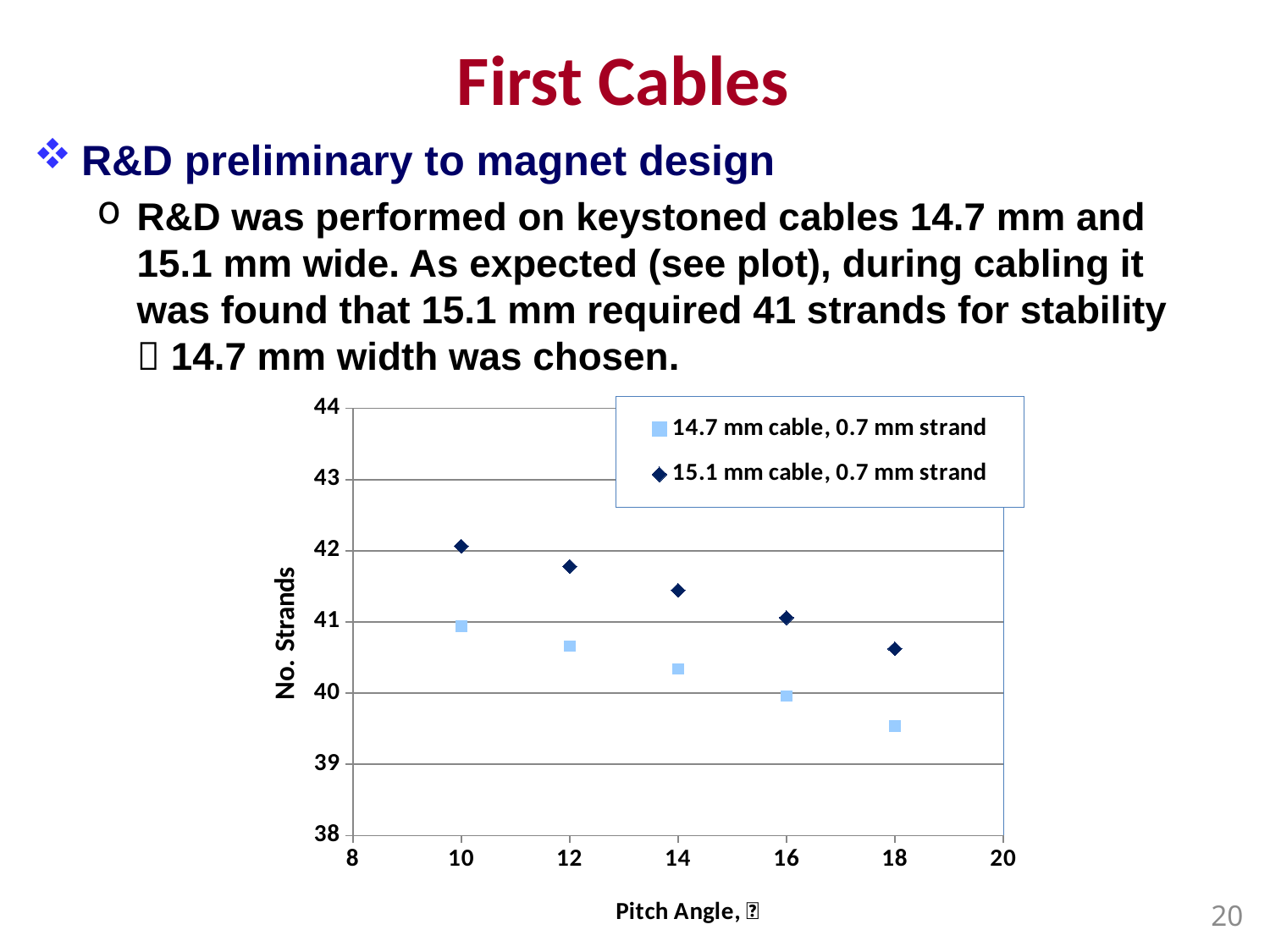
At a pitch angle of 14, which series has the higher number of strands: 14.7 mm cable or 15.1 mm cable? 15.1 mm cable, 0.7 mm strand How many data points are plotted for the 14.7 mm cable, 0.7 mm strand series? 5 Is the number of strands for the 15.1 mm cable at pitch angle 12 greater or less than 41? greater At which pitch angle does the 15.1 mm cable series have its highest number of strands? 10 What is the label of the vertical axis of the chart? No. Strands At which pitch angle does the 14.7 mm cable series have its lowest number of strands? 18 How many series does the legend list? 2 Is the number of strands for the 14.7 mm cable at pitch angle 14 greater or less than 40? greater Do the number of strands rise or fall as the pitch angle increases? fall Is the number of strands for the 14.7 mm cable at pitch angle 18 greater or less than 40? less What kind of chart is shown on the slide? scatter chart